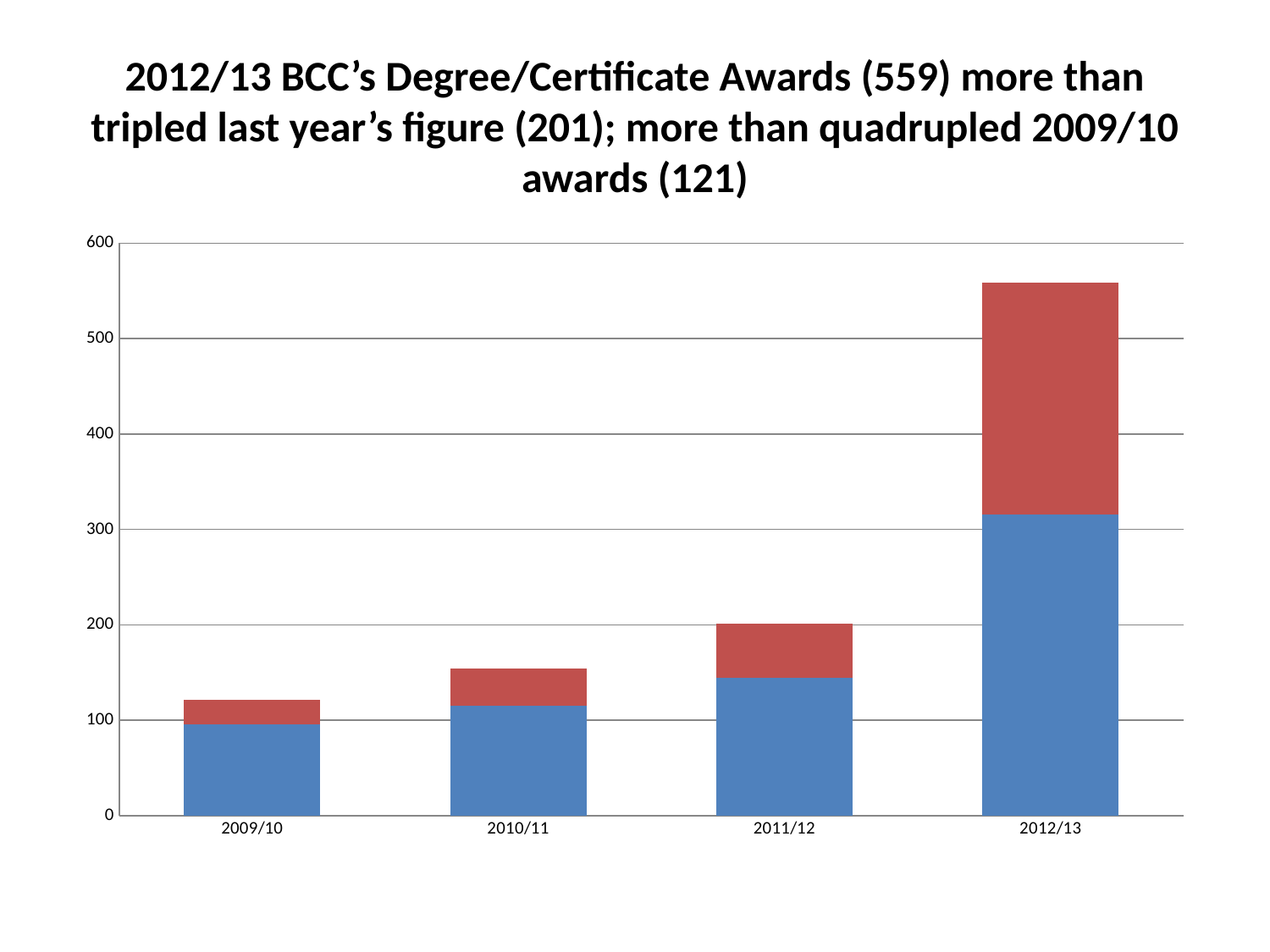
Do the total awards rise or fall from 2009/10 to 2012/13? rise What kind of chart is shown on the slide? stacked bar chart Is the blue segment for 2012/13 greater or less than 300? greater Is the total bar for 2010/11 greater or less than 200? less How many academic years are shown on the x axis? 4 According to the slide, what was the total number of awards in 2009/10? 121 Is the total bar for 2011/12 larger than the total bar for 2010/11? yes According to the slide, what was the total number of awards in 2011/12? 201 Which year has the highest total bar? 2012/13 What is the difference between the 2012/13 total (559) and the 2011/12 total (201)? 358 According to the slide, what was the total number of Degree/Certificate Awards in 2012/13? 559 Which year has the lowest total bar? 2009/10